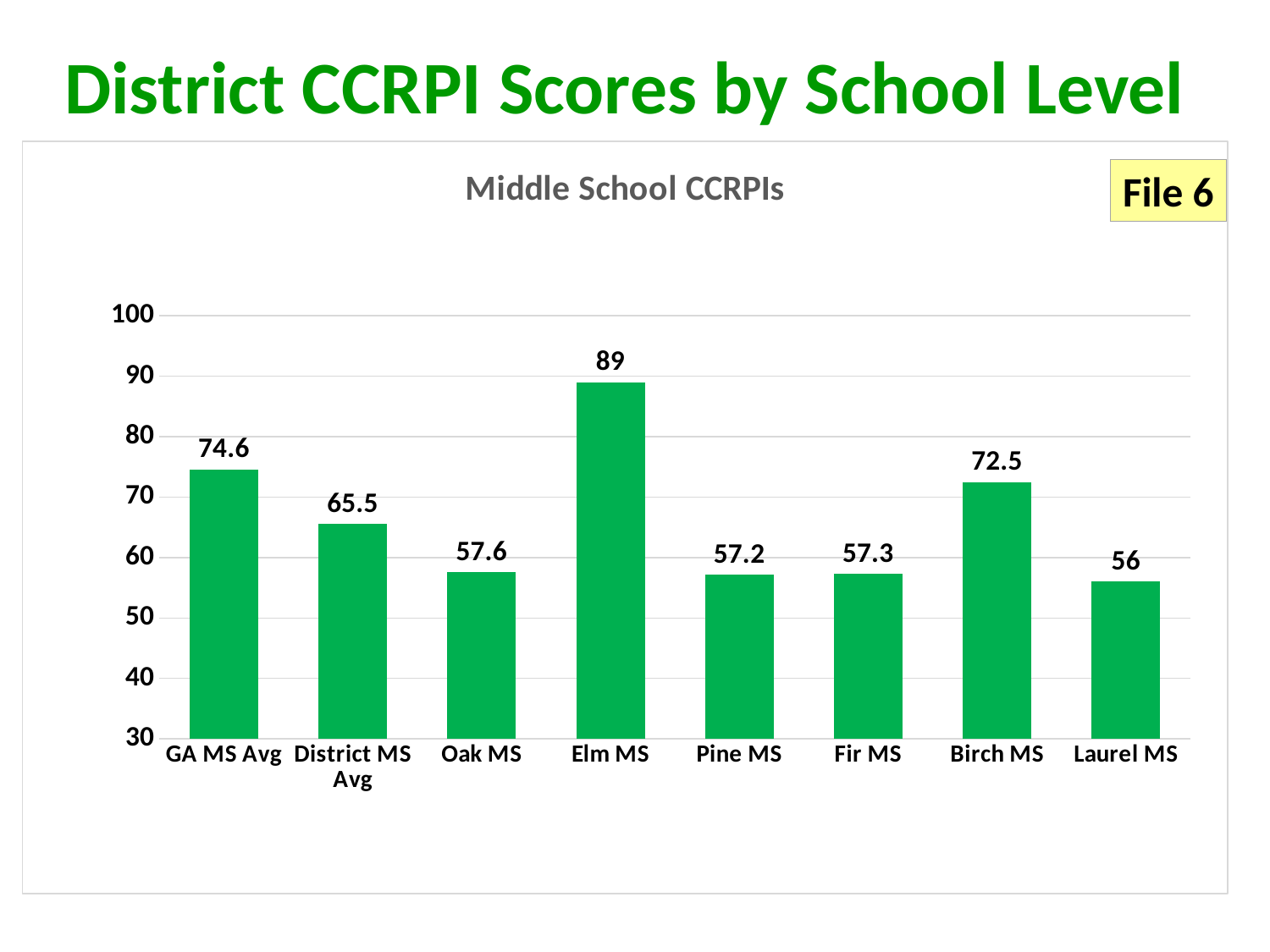
What is the CCRPI score for Elm MS? 89 Which school or category has the highest CCRPI score? Elm MS What is the value shown for District MS Avg? 65.5 How many bars are shown in the chart? 8 Which is larger, the value for Oak MS or the value for Birch MS? Birch MS Is the value for Elm MS greater or less than 80? greater What kind of chart is shown on the slide? bar chart What is the title of the chart? Middle School CCRPIs What is the difference between the GA MS Avg and the District MS Avg? 9.1 Which school or category has the lowest CCRPI score? Laurel MS What is the CCRPI score for Birch MS? 72.5 What is the difference between Elm MS and Birch MS? 16.5